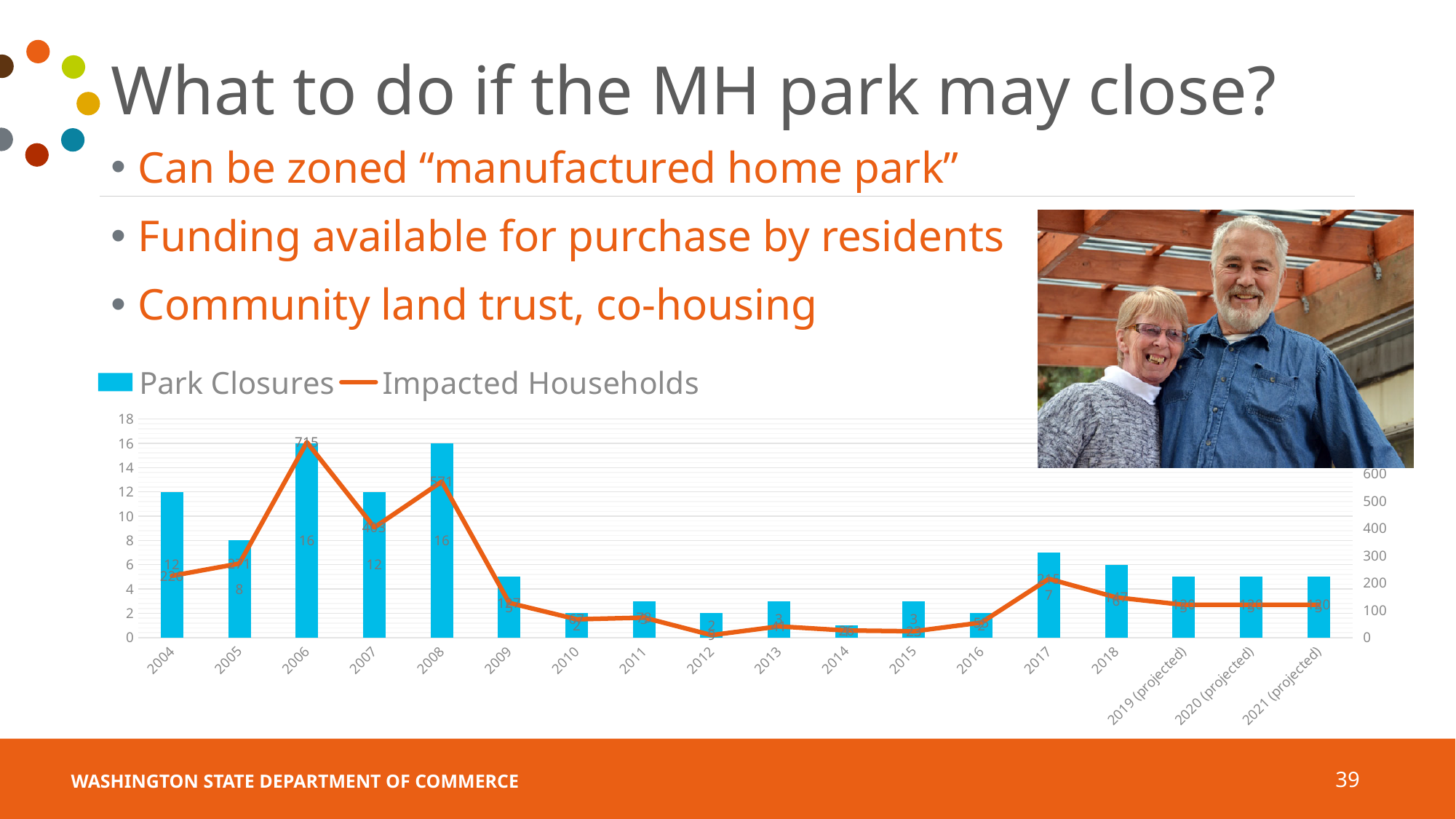
What kind of chart is shown on the slide? Combined bar and line chart How many years (categories) are shown on the x axis of the chart? 18 What are the two series named in the chart legend? Park Closures and Impacted Households What is the number of Park Closures in 2017? 7 What is the number of Park Closures in 2004? 12 In which year is the Park Closures bar the lowest? 2014 In which year is the Impacted Households line at its highest? 2006 How many series does the chart legend list? 2 What is the number of Park Closures in 2008? 16 What is the difference in Park Closures between 2004 and 2005? 4 What is the value of Impacted Households in 2006? 715 Which year has more Park Closures, 2009 or 2018? 2018